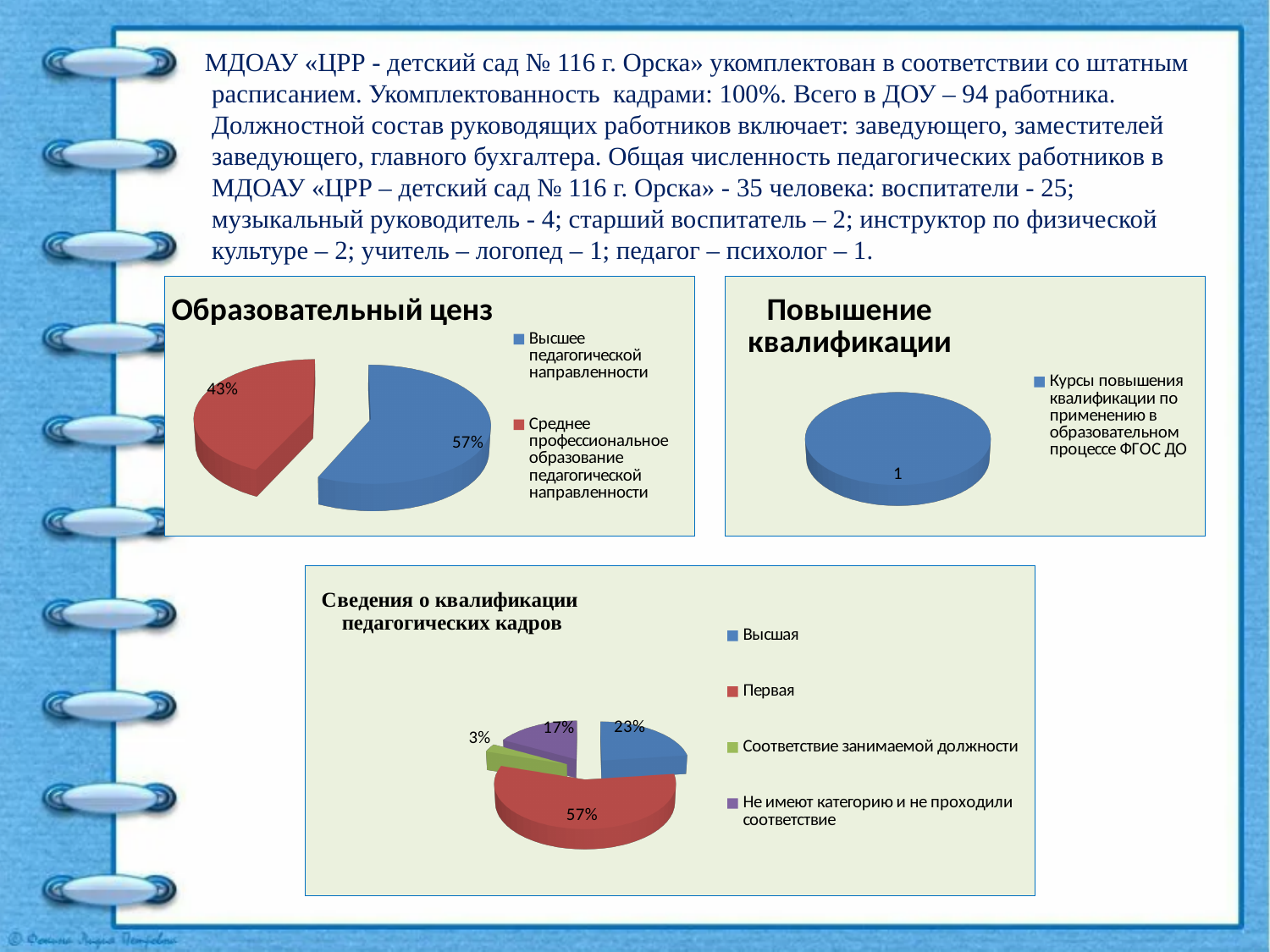
How many entries does the legend of the chart titled «Повышение квалификации» list? 1 In the chart titled «Сведения о квалификации педагогических кадров», what percentage is shown for «Первая»? 57% What kind of chart is the one titled «Образовательный ценз»? Pie chart In the chart titled «Образовательный ценз», what is the difference in percentage points between the two slices? 14 In the chart titled «Образовательный ценз», what percentage is shown for «Высшее педагогической направленности»? 57% In the chart titled «Сведения о квалификации педагогических кадров», which is larger: «Высшая» or «Не имеют категорию и не проходили соответствие»? Высшая In the chart titled «Образовательный ценз», what percentage is shown for «Среднее профессиональное образование педагогической направленности»? 43% How many slices does the pie in the chart titled «Сведения о квалификации педагогических кадров» have? 4 In the chart titled «Сведения о квалификации педагогических кадров», which category has the smallest share? Соответствие занимаемой должности In the chart titled «Образовательный ценз», which category has the larger share? Высшее педагогической направленности In the chart titled «Повышение квалификации», what value is printed on the pie? 1 In the chart titled «Сведения о квалификации педагогических кадров», what percentage is shown for «Соответствие занимаемой должности»? 3%